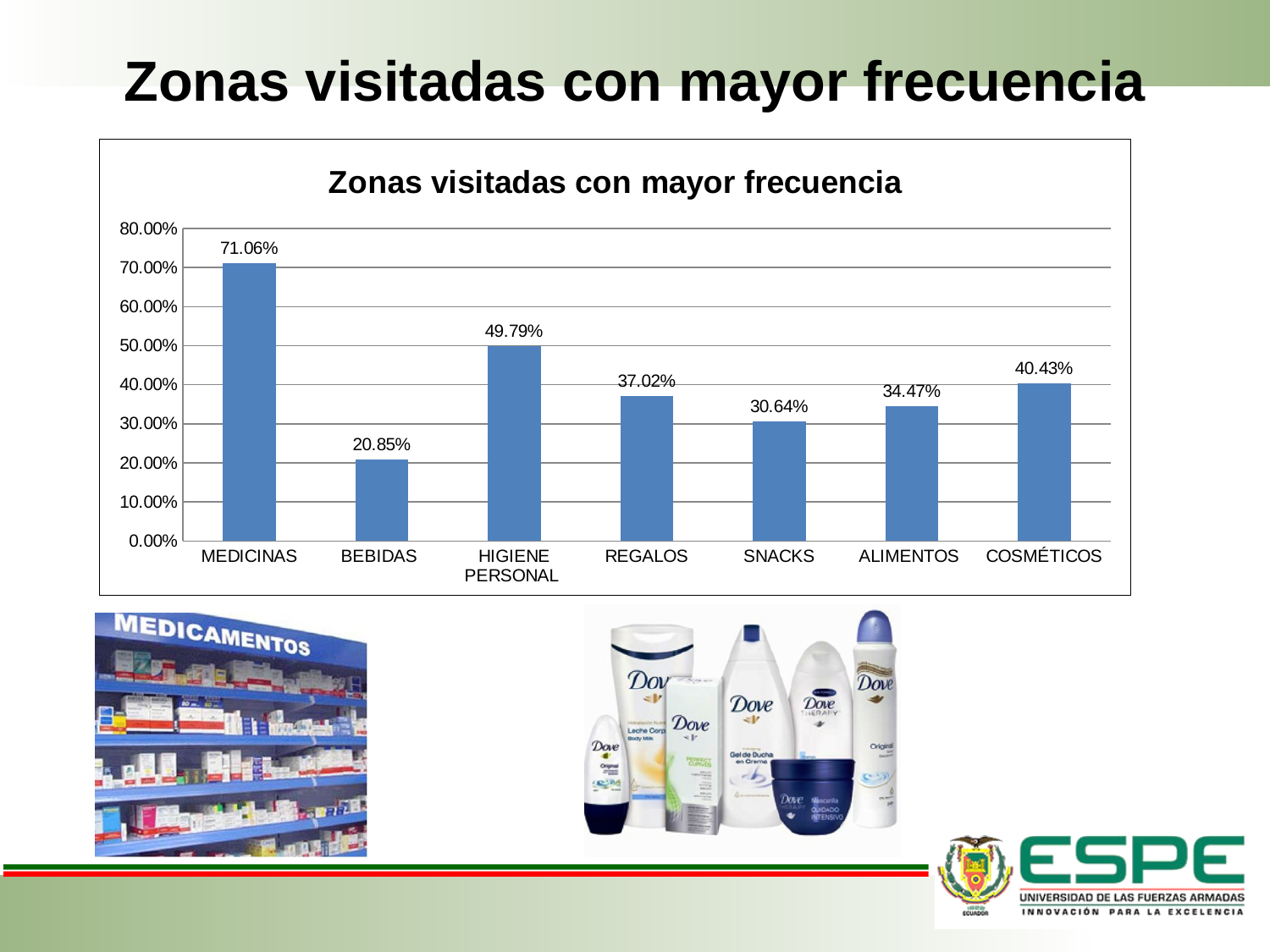
What is the value for SNACKS? 30.64% Which category has the lowest value? BEBIDAS What is the difference between the values for MEDICINAS and BEBIDAS? 50.21% What kind of chart is shown? bar chart What is the title of the chart? Zonas visitadas con mayor frecuencia Is the value for COSMÉTICOS greater or less than 50.00%? less Which is larger, the value for REGALOS or the value for ALIMENTOS? REGALOS How many categories are shown on the x axis? 7 Which category has the highest value? MEDICINAS What is the difference between the values for COSMÉTICOS and ALIMENTOS? 5.96% What is the value for MEDICINAS? 71.06% What is the value for HIGIENE PERSONAL? 49.79%